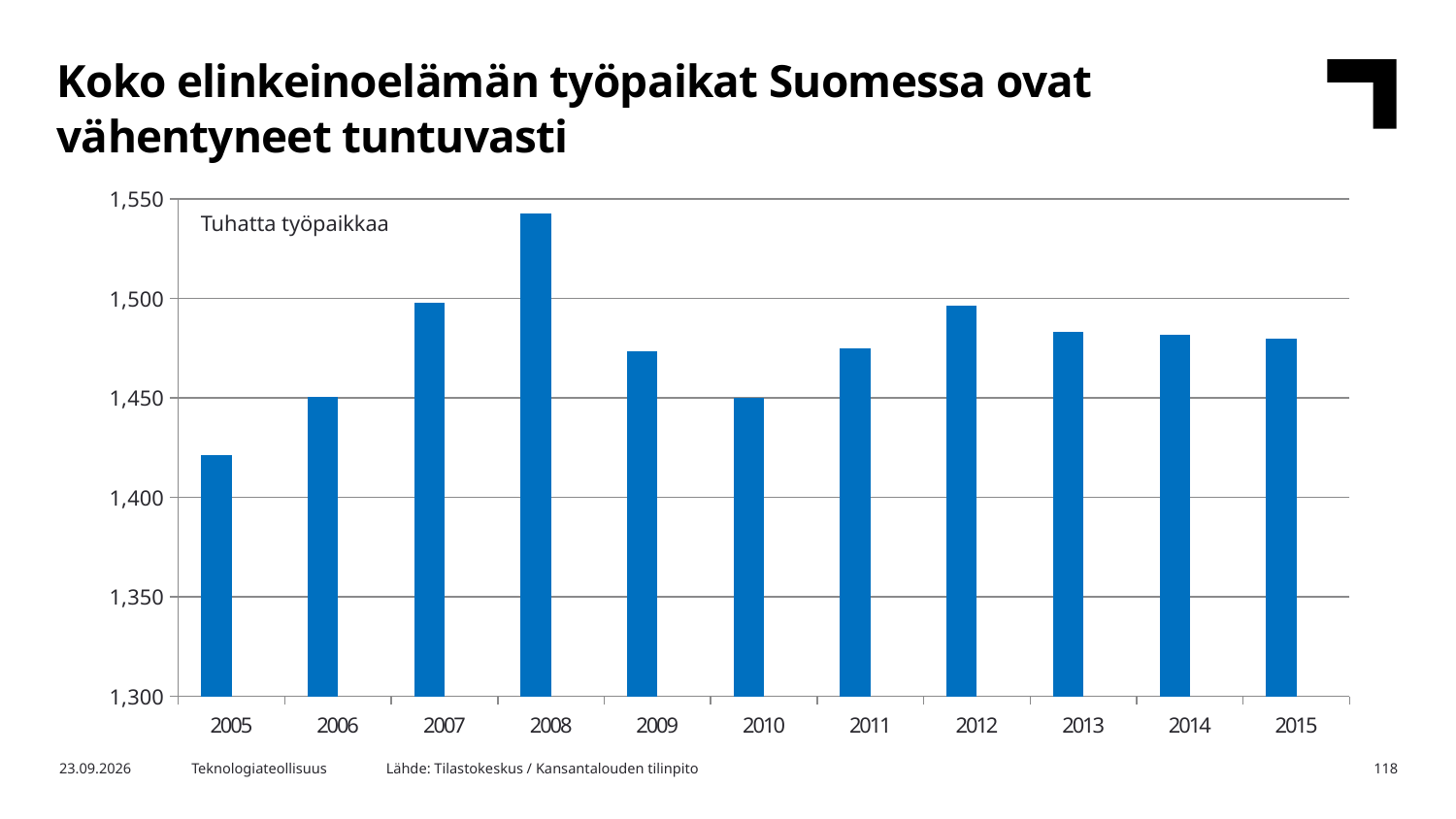
Is the value for 2015 greater or less than 1,500? less What kind of chart is shown on the slide? Bar chart Which year has the highest number of jobs in the chart? 2008 Which year has a higher value, 2009 or 2010? 2009 What unit label is shown inside the chart area? Tuhatta työpaikkaa Is the value for 2009 greater or less than 1,450? greater Is the value for 2008 greater or less than 1,500? greater Which year has a higher value, 2007 or 2006? 2007 How many years are shown on the x axis of the chart? 11 Which year has the lowest number of jobs in the chart? 2005 Do the values rise or fall from 2008 to 2010? fall